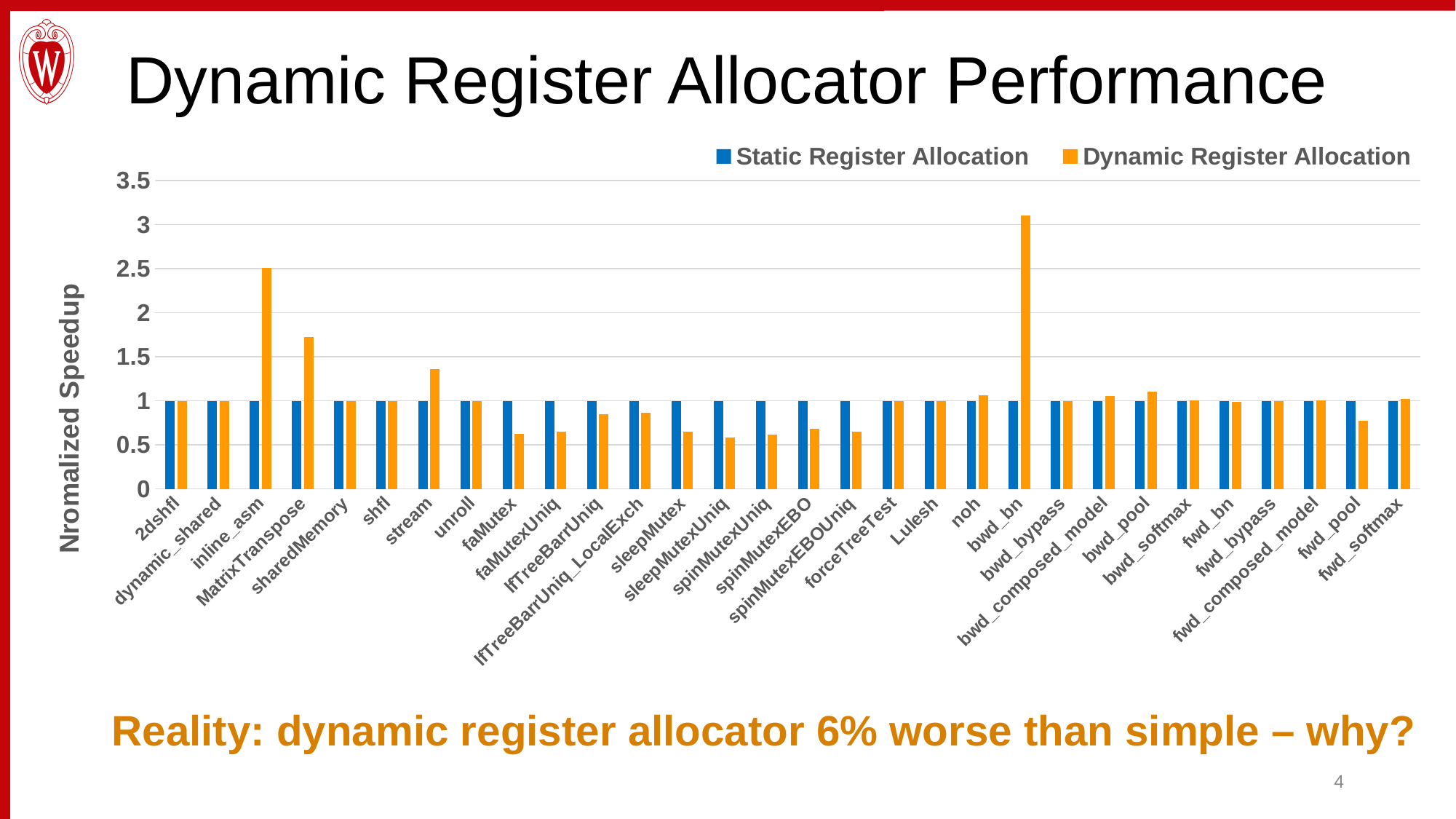
Which has the larger Dynamic Register Allocation value, stream or fwd_pool? stream Which has the larger Dynamic Register Allocation value, inline_asm or MatrixTranspose? inline_asm Is the Dynamic Register Allocation value for bwd_bn greater or less than 2.5? greater Is the Dynamic Register Allocation value for inline_asm greater or less than 2? greater Is the Dynamic Register Allocation value for MatrixTranspose greater or less than 1.5? greater What colour represents Dynamic Register Allocation in the legend? orange Which category has the highest Dynamic Register Allocation value? bwd_bn How many series does the legend list? 2 How many categories (benchmarks) are plotted along the x axis? 30 What is the Static Register Allocation value for 2dshfl? 1 What kind of chart is shown on the slide? bar chart